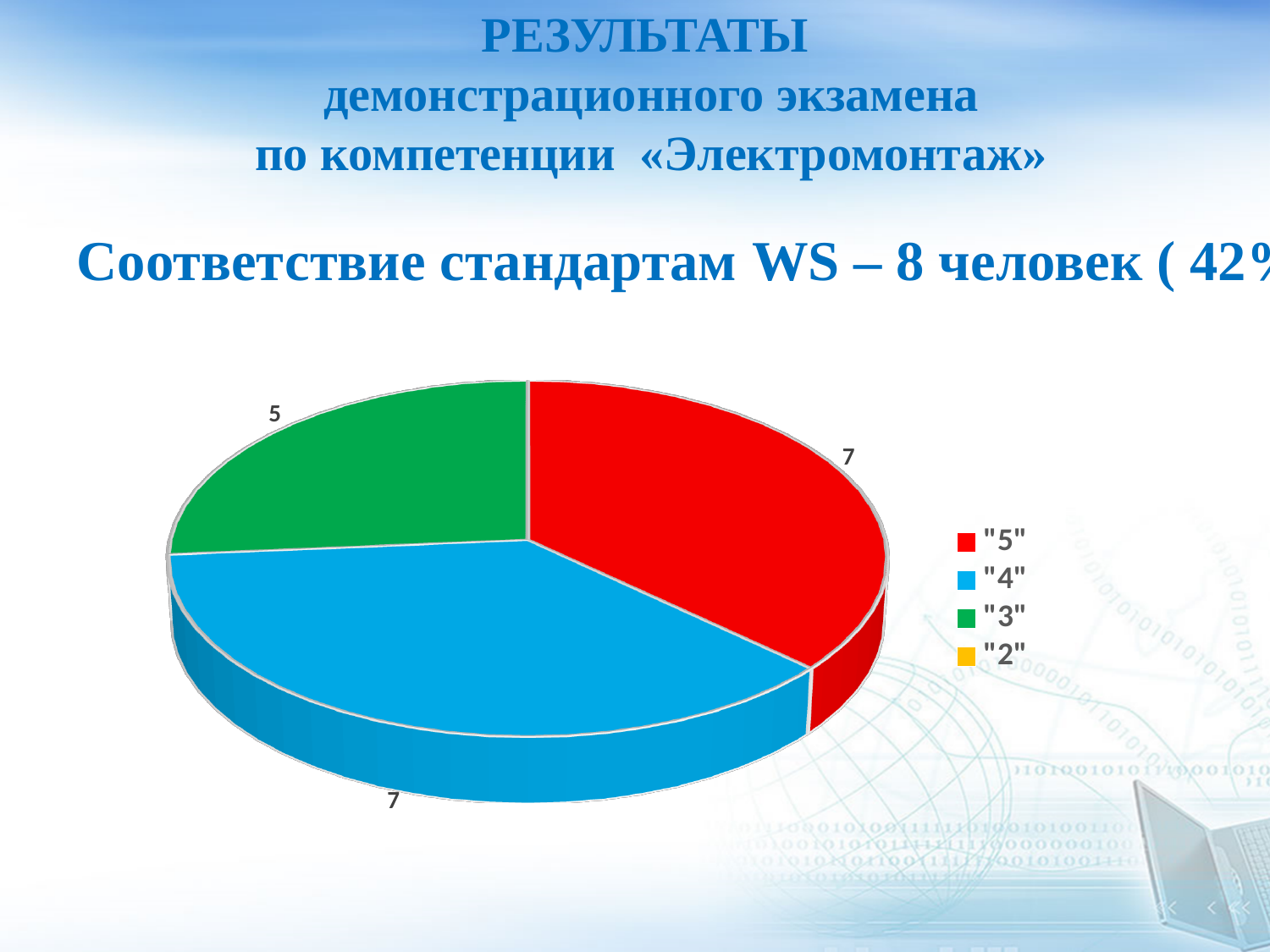
What colour is the "3" slice in the pie chart? green How many entries does the legend of the pie chart list? 4 What is the difference between the "4" slice and the "3" slice in the pie chart? 2 What colour is the "4" slice in the pie chart? blue What kind of chart is shown on the slide? pie chart What is the value of the "3" slice in the pie chart? 5 Which is larger in the pie chart, the "5" slice or the "3" slice? "5" What is the value of the "5" slice in the pie chart? 7 Which of the visible slices in the pie chart is the smallest? "3" What is the value of the "4" slice in the pie chart? 7 How many slices are visible in the pie chart? 3